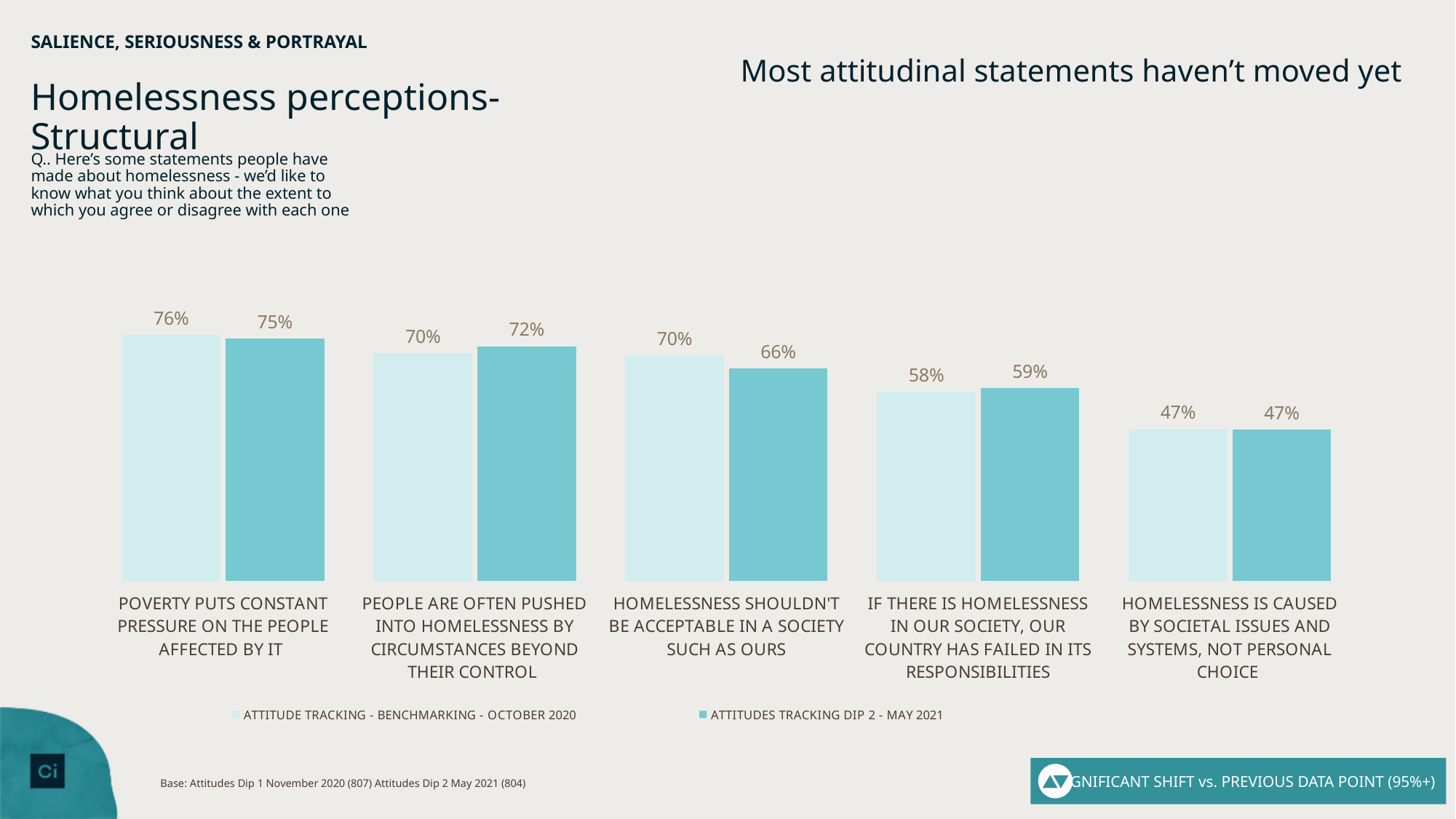
How many statements (categories) are shown on the chart? 5 What kind of chart is shown on the slide? Bar chart What is the October 2020 value for 'Homelessness is caused by societal issues and systems, not personal choice'? 47% Which statement has the highest value in the October 2020 series? Poverty puts constant pressure on the people affected by it What is the difference between the October 2020 and May 2021 values for 'Homelessness shouldn't be acceptable in a society such as ours'? 4% What is the value for 'Poverty puts constant pressure on the people affected by it' in the Attitude Tracking - Benchmarking - October 2020 series? 76% How many series does the legend list? 2 What is the May 2021 value for 'People are often pushed into homelessness by circumstances beyond their control'? 72% For 'If there is homelessness in our society, our country has failed in its responsibilities', which is larger: the October 2020 value or the May 2021 value? May 2021 Which statement has the lowest value in the May 2021 series? Homelessness is caused by societal issues and systems, not personal choice What is the value for 'Homelessness shouldn't be acceptable in a society such as ours' in the Attitudes Tracking Dip 2 - May 2021 series? 66% What is the name of the second series in the legend? Attitudes Tracking Dip 2 - May 2021